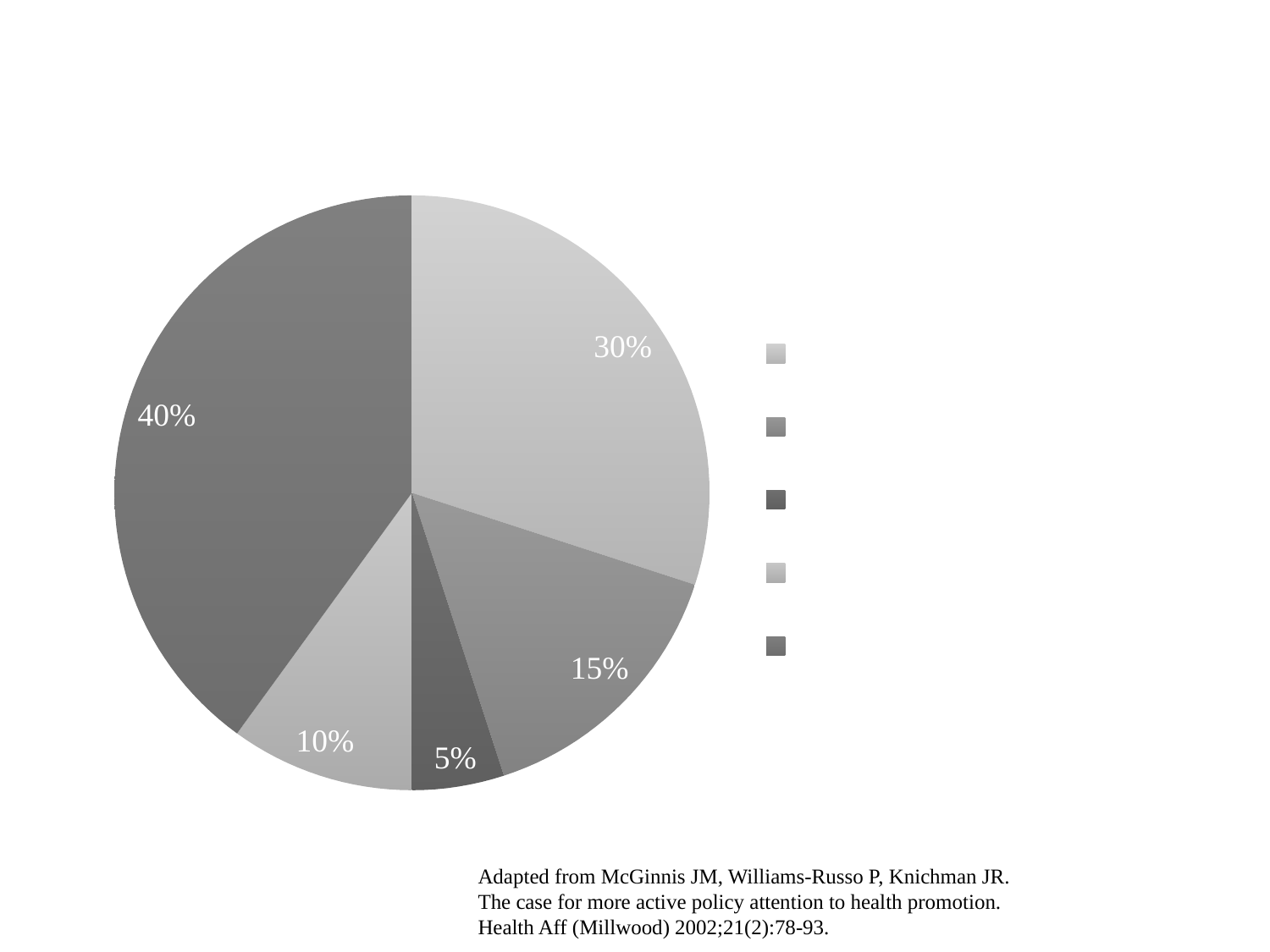
What is the value of the largest slice of the pie chart? 40% How much larger is the largest slice than the second-largest slice in the pie chart? 10% What is the value of the smallest slice of the pie chart? 5% Is the largest slice of the pie chart more or less than half of the pie? less What kind of chart is shown on the slide? pie chart What share of the pie do the two largest slices make up together? 70% What is the difference between the largest and smallest slices of the pie chart? 35% Which is larger in the pie chart, the 15% slice or the 10% slice? the 15% slice What value is printed on the slice occupying the left side of the pie chart? 40% How many entries does the legend of the pie chart list? 5 How many slices does the pie chart have? 5 What value is printed on the slice in the upper right of the pie chart? 30%